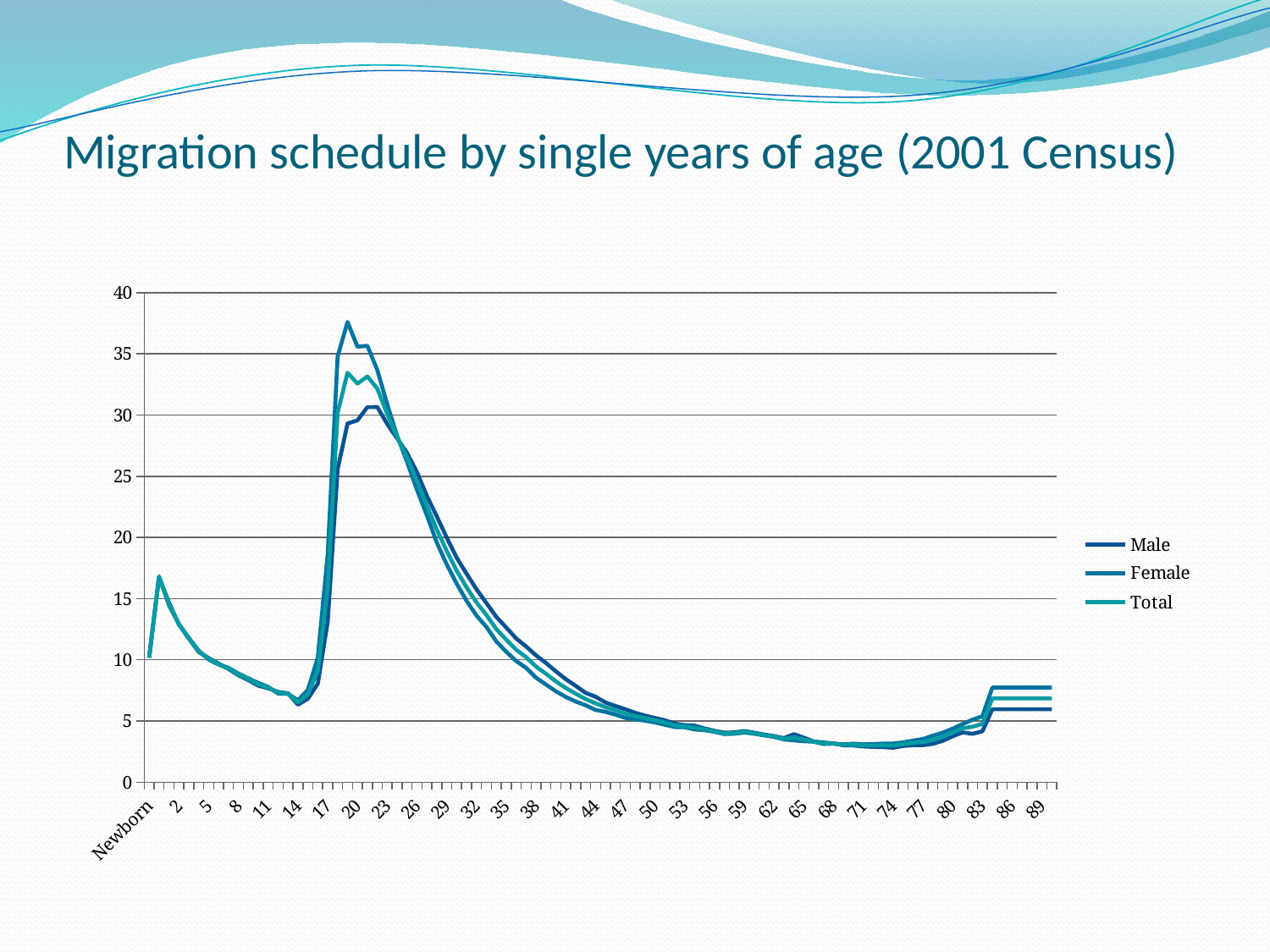
Is the peak value of the Male series greater or less than 35? less At age 86, which series is higher, Male or Female? Female What is the title of the chart? Migration schedule by single years of age (2001 Census) Which series reaches the highest peak value? Female Is the peak value of the Female series greater or less than 35? greater Between ages 23 and 50, do the values rise or fall along the x axis? fall Is the value for the Total series at age 74 greater or less than 5? less What kind of chart is shown on the slide? line chart What are the series names listed in the legend? Male, Female, Total How many series does the legend list? 3 At age 19, which series is higher, Male or Female? Female